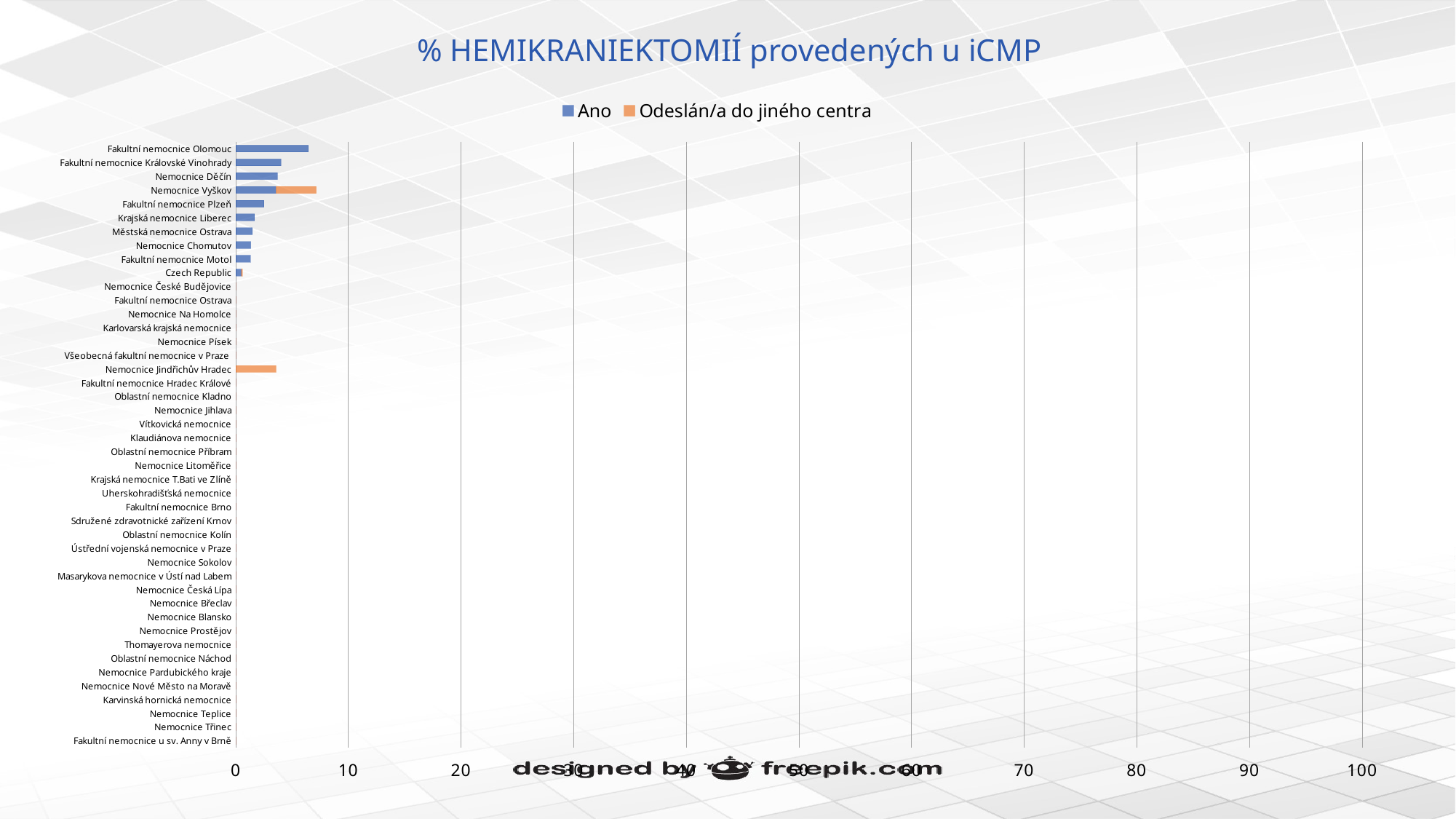
Which category has the highest value for the 'Odeslán/a do jiného centra' series? Nemocnice Vyškov and Nemocnice Jindřichův Hradec (tied) How many hospitals (categories) are listed on the vertical axis? 44 Which has the larger 'Ano' value: Fakultní nemocnice Olomouc or Fakultní nemocnice Královské Vinohrady? Fakultní nemocnice Olomouc Is the 'Ano' value for Fakultní nemocnice Olomouc greater or less than 10? less How many series does the legend list? 2 Which has the larger 'Odeslán/a do jiného centra' value: Nemocnice Vyškov or Nemocnice Jindřichův Hradec? They are equal What are the two series named in the legend? Ano; Odeslán/a do jiného centra Is the 'Odeslán/a do jiného centra' value for Nemocnice Vyškov greater or less than 10? less What kind of chart is shown on the slide? Bar chart Which has the larger 'Ano' value: Fakultní nemocnice Plzeň or Krajská nemocnice Liberec? Fakultní nemocnice Plzeň Which category has the highest value for the 'Ano' series? Fakultní nemocnice Olomouc What is the title of the chart? % HEMIKRANIEKTOMIÍ provedených u iCMP